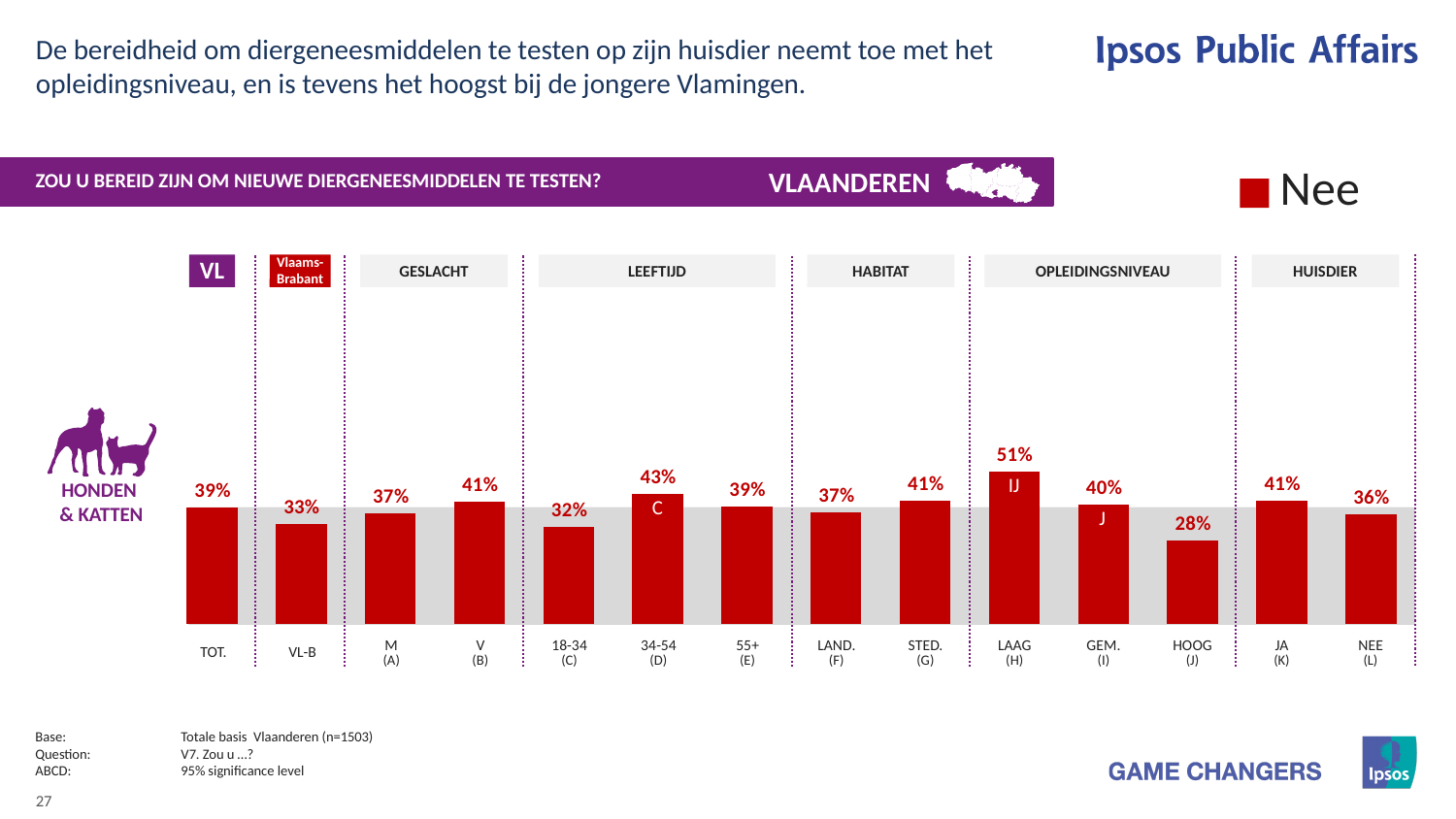
What is the difference between the values for JA (K) and NEE (L)? 5% How many series does the legend list? 1 What kind of chart is shown on the slide? Bar chart What is the value for TOT.? 39% Which category has the lowest value? HOOG (J) How many bars are shown in the chart? 14 What is the value for HOOG (J) under OPLEIDINGSNIVEAU? 28% What is the difference between the values for LAAG (H) and HOOG (J)? 23% What is the value for the 34-54 (D) age group? 43% What is the value for VL-B? 33% Which category has the highest value? LAAG (H) Which is larger, the value for M (A) or V (B)? V (B)